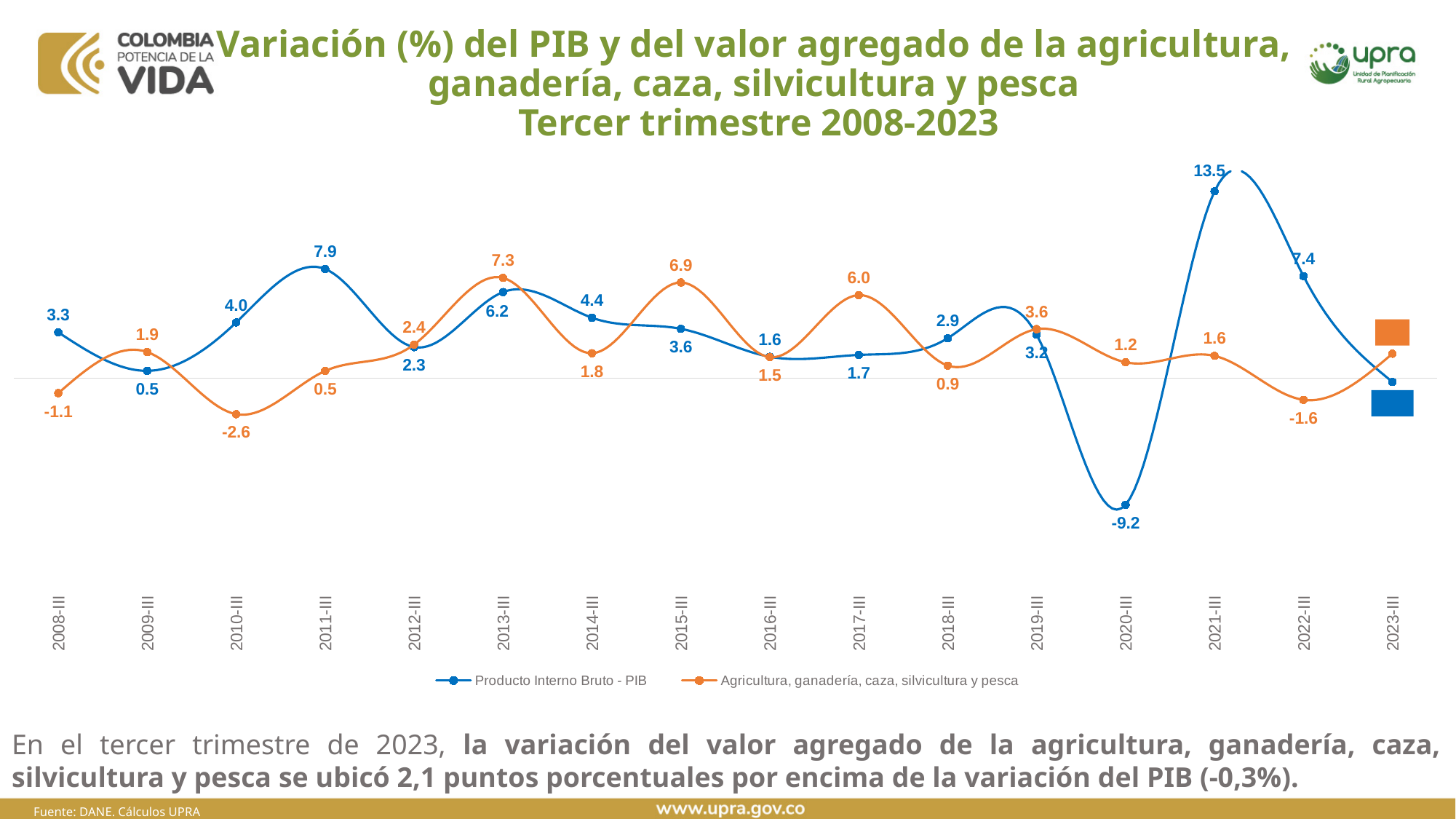
How many quarters (categories) are plotted along the x axis? 16 What is the value for Agricultura, ganadería, caza, silvicultura y pesca in 2013-III? 7.3 What kind of chart is shown on the slide? line chart In 2015-III, which series has the larger value: Producto Interno Bruto - PIB or Agricultura, ganadería, caza, silvicultura y pesca? Agricultura, ganadería, caza, silvicultura y pesca What is the value for Producto Interno Bruto - PIB in 2011-III? 7.9 Does the Producto Interno Bruto - PIB series rise or fall from 2021-III to 2022-III? fall In which quarter does Producto Interno Bruto - PIB reach its highest value? 2021-III How many series does the legend list? 2 Which colour is used for the Agricultura, ganadería, caza, silvicultura y pesca line? orange What is the value for Producto Interno Bruto - PIB in 2020-III? -9.2 What is the difference between the PIB value in 2021-III (13.5) and in 2022-III (7.4)? 6.1 In which quarter does Agricultura, ganadería, caza, silvicultura y pesca reach its lowest value? 2010-III